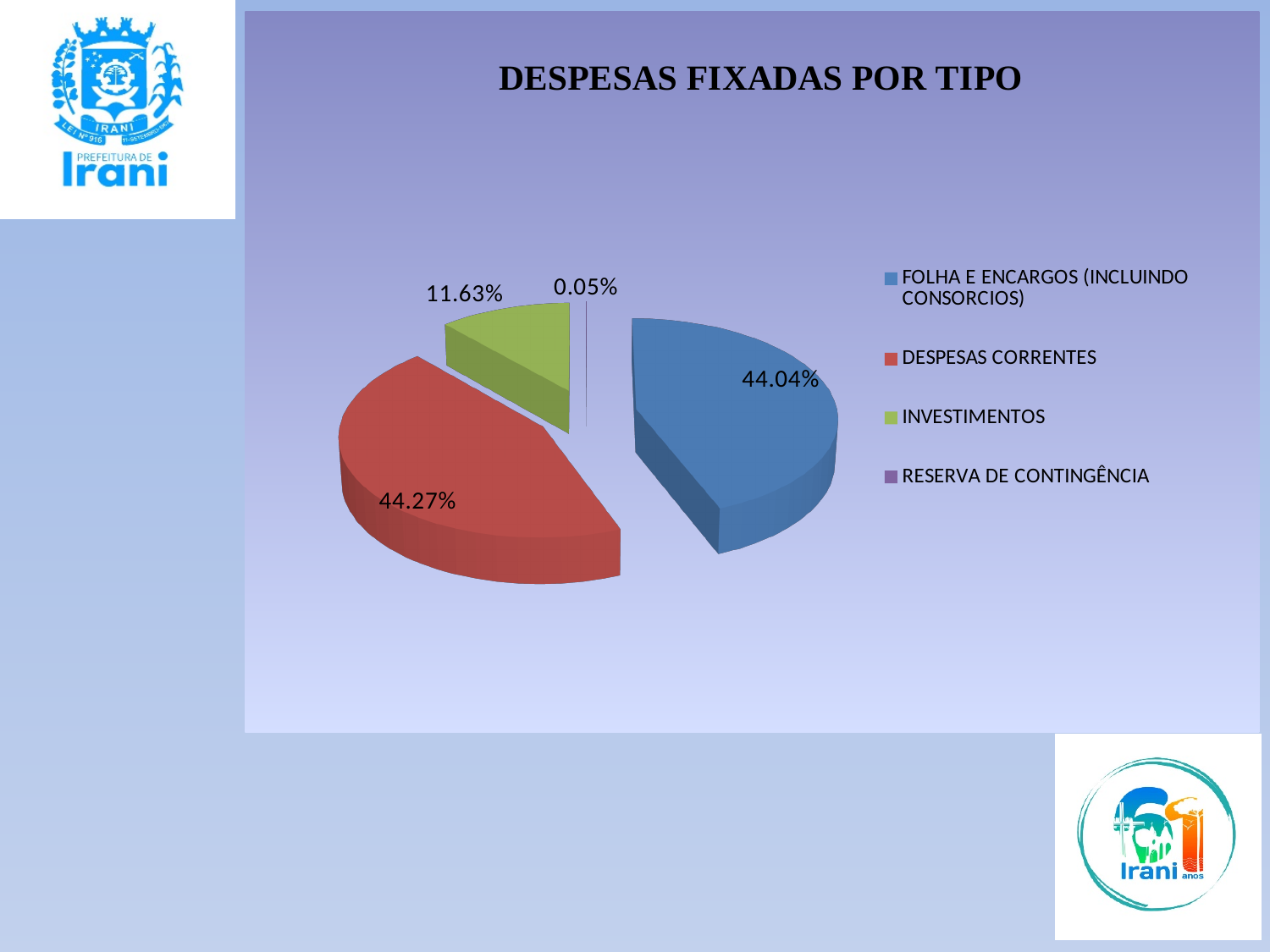
What kind of chart is shown on the slide? Pie chart What is the value labelled for INVESTIMENTOS? 11.63% How many categories are shown in the pie chart? 4 Which category has the largest share of the pie? DESPESAS CORRENTES What percentage is shown for FOLHA E ENCARGOS (INCLUINDO CONSORCIOS)? 44.04% What percentage is shown for RESERVA DE CONTINGÊNCIA? 0.05% What is the difference between the shares of DESPESAS CORRENTES and FOLHA E ENCARGOS (INCLUINDO CONSORCIOS)? 0.23% What is the title of the chart? DESPESAS FIXADAS POR TIPO Which is larger, the share for INVESTIMENTOS or the share for RESERVA DE CONTINGÊNCIA? INVESTIMENTOS What share of the pie does DESPESAS CORRENTES represent? 44.27% Which category has the smallest share of the pie? RESERVA DE CONTINGÊNCIA What is the difference between the shares of FOLHA E ENCARGOS (INCLUINDO CONSORCIOS) and INVESTIMENTOS? 32.41%